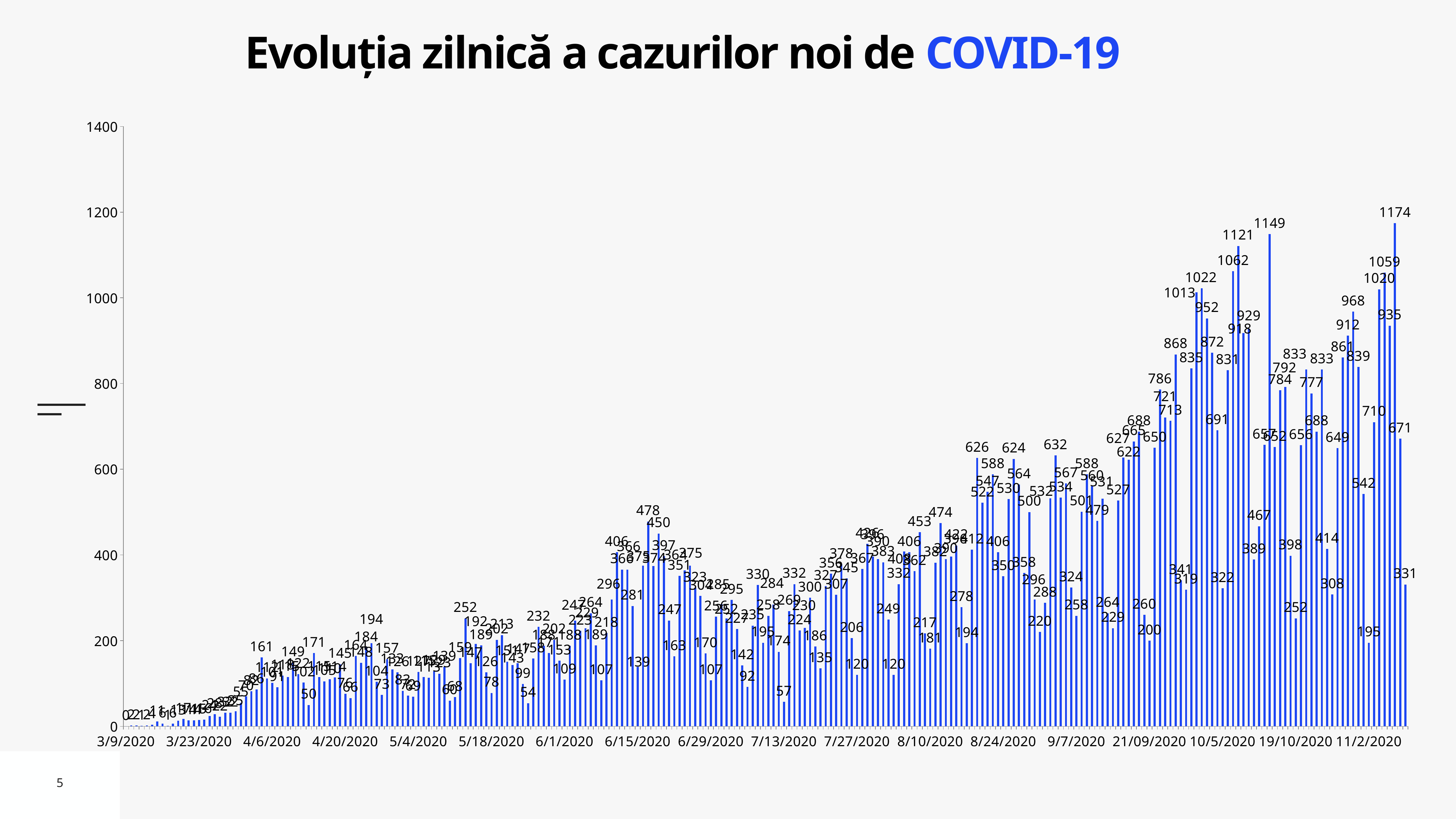
How many bars have a labelled value above 1000? 8 Overall, do the daily values rise or fall from left to right along the x axis? rise What is the maximum value shown on the vertical axis? 1400 What kind of chart is shown on the slide? bar chart What is the highest daily value shown on the chart? 1174 Is the highest value on the chart greater or less than 1200? less Is the value of the first bar (3/9/2020) greater or less than 200? less What is the value of the last (rightmost) bar on the chart? 331 What is the title of the chart? Evoluția zilnică a cazurilor noi de COVID-19 Which is larger, the bar labelled 1149 or the bar labelled 1121? 1149 What is the second-highest daily value labelled on the chart? 1149 What is the difference between the highest value (1174) and the bar labelled 1149? 25